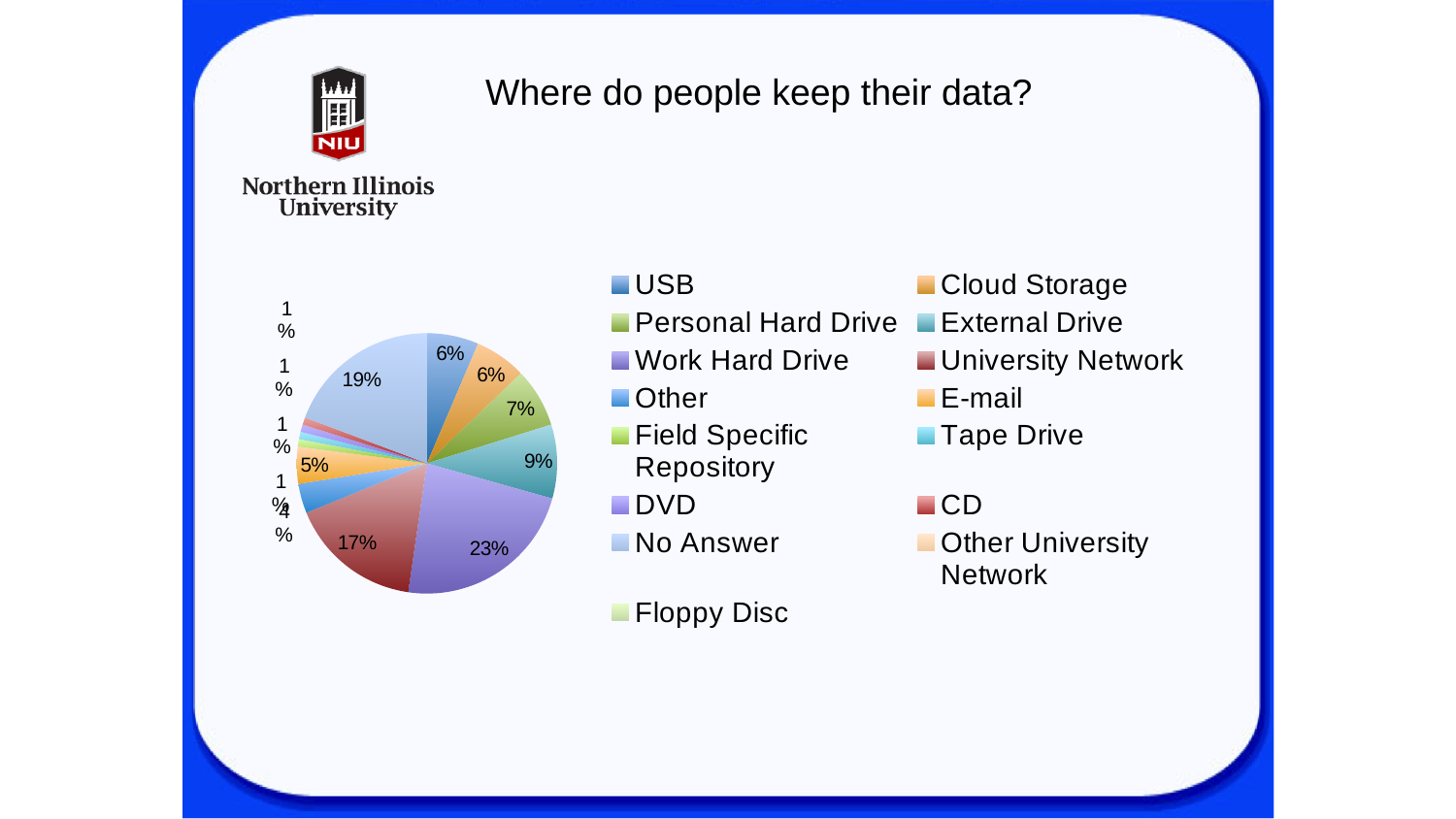
Which is larger, the share for Personal Hard Drive or the share for External Drive? External Drive What percentage of the pie is No Answer? 19% What percentage of the pie is Work Hard Drive? 23% What kind of chart is shown on the slide? pie chart What percentage of the pie is University Network? 17% What percentage of the pie is External Drive? 9% What percentage of the pie is E-mail? 5% Which category has the largest share of the pie? Work Hard Drive What is the title of the chart on the slide? Where do people keep their data? How many categories does the legend list? 15 What is the difference between the Work Hard Drive share and the University Network share? 6% Which is larger, the share for University Network or the share for No Answer? No Answer